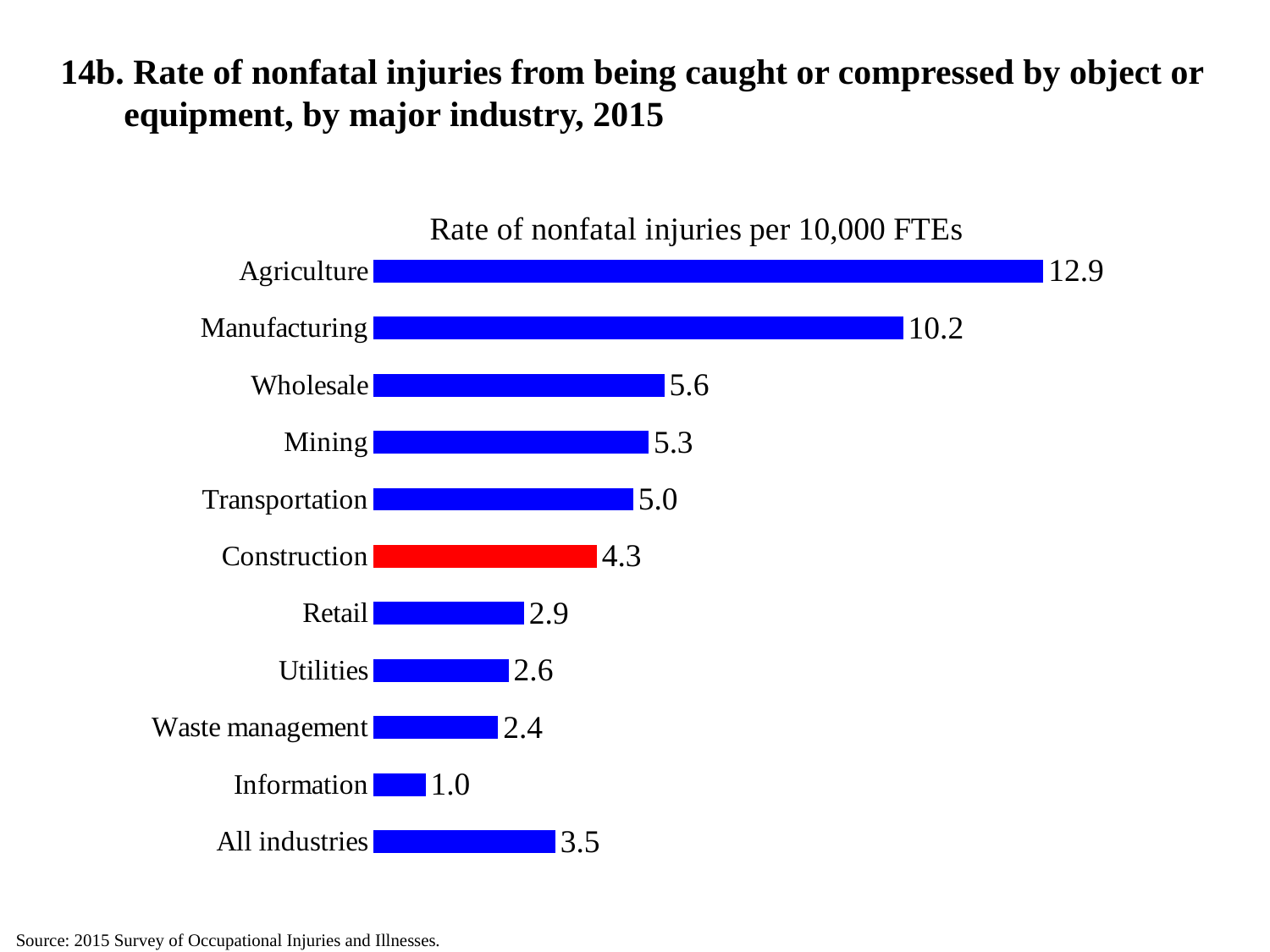
What is the difference between the rates for Agriculture and Manufacturing? 2.7 What is the rate of nonfatal injuries per 10,000 FTEs for Manufacturing? 10.2 What is the rate of nonfatal injuries per 10,000 FTEs for Construction? 4.3 Which has a higher rate of nonfatal injuries, Wholesale or Mining? Wholesale What is the rate of nonfatal injuries per 10,000 FTEs for All industries? 3.5 Which industry has the lowest rate of nonfatal injuries per 10,000 FTEs? Information What is the difference between the rates for Construction and All industries? 0.8 Which industry's bar is coloured red instead of blue? Construction What kind of chart is shown on the slide? Bar chart Which has a higher rate of nonfatal injuries, Retail or Utilities? Retail How many industry categories are shown in the chart? 11 Which industry has the highest rate of nonfatal injuries per 10,000 FTEs? Agriculture